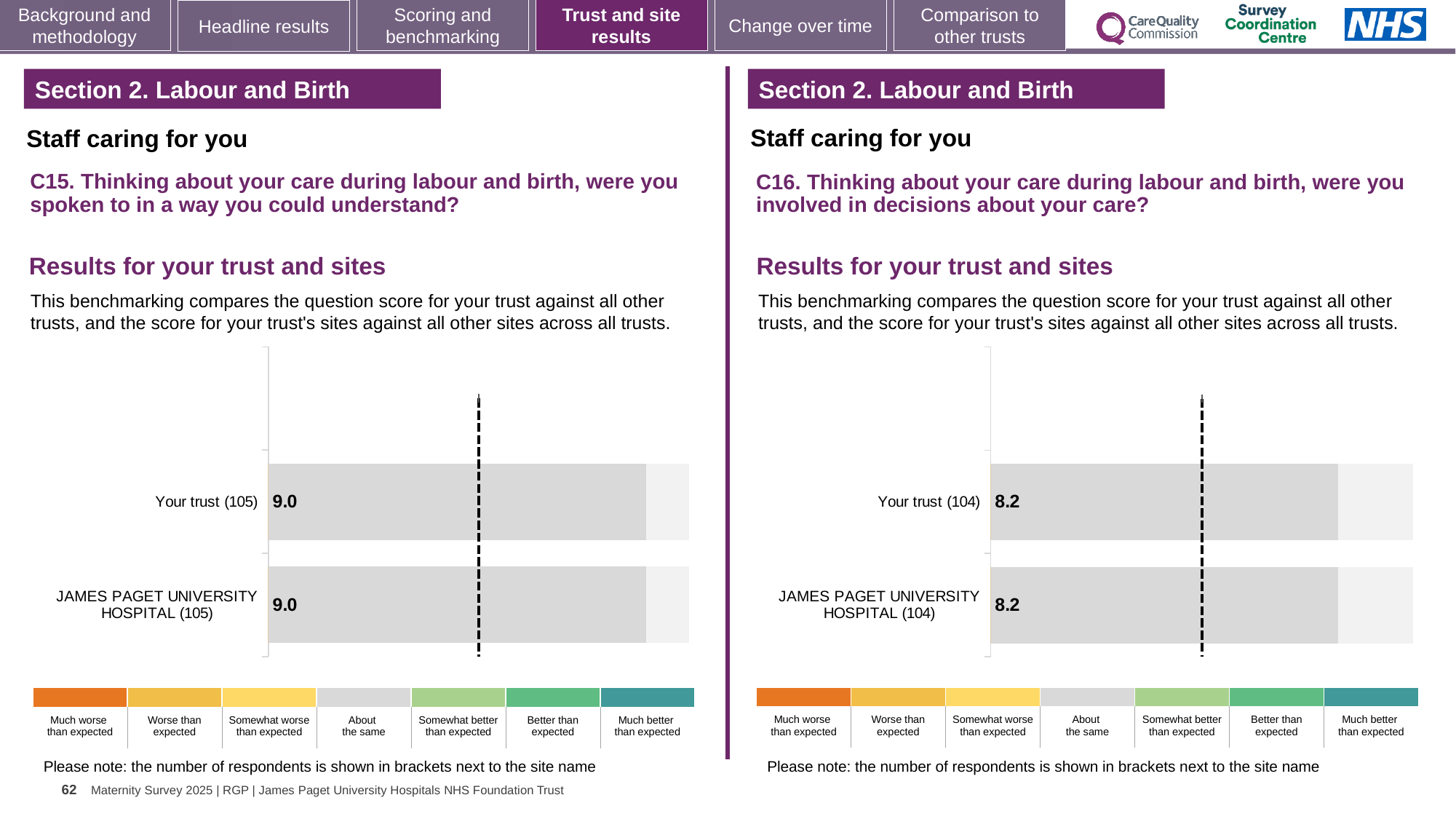
In the C16 chart on the right, what is the score for JAMES PAGET UNIVERSITY HOSPITAL (104)? 8.2 In the C16 chart on the right, what is the score for Your trust (104)? 8.2 In the colour key below the C16 chart on the right, which category is shown in orange? Much worse than expected What kind of chart is used in the C15 chart on the left? Bar chart In the C15 chart on the left, what is the score for JAMES PAGET UNIVERSITY HOSPITAL (105)? 9.0 Is the Your trust score in the C15 chart on the left larger than the Your trust score in the C16 chart on the right? Yes How many respondents are shown in brackets for Your trust in the C16 chart on the right? 104 How many benchmark categories does the colour key below the C15 chart on the left list? 7 In the C15 chart on the left, what is the score for Your trust (105)? 9.0 In the C15 chart on the left, what is the difference between the score for Your trust and the score for JAMES PAGET UNIVERSITY HOSPITAL? 0.0 How many bars are plotted in the C16 chart on the right? 2